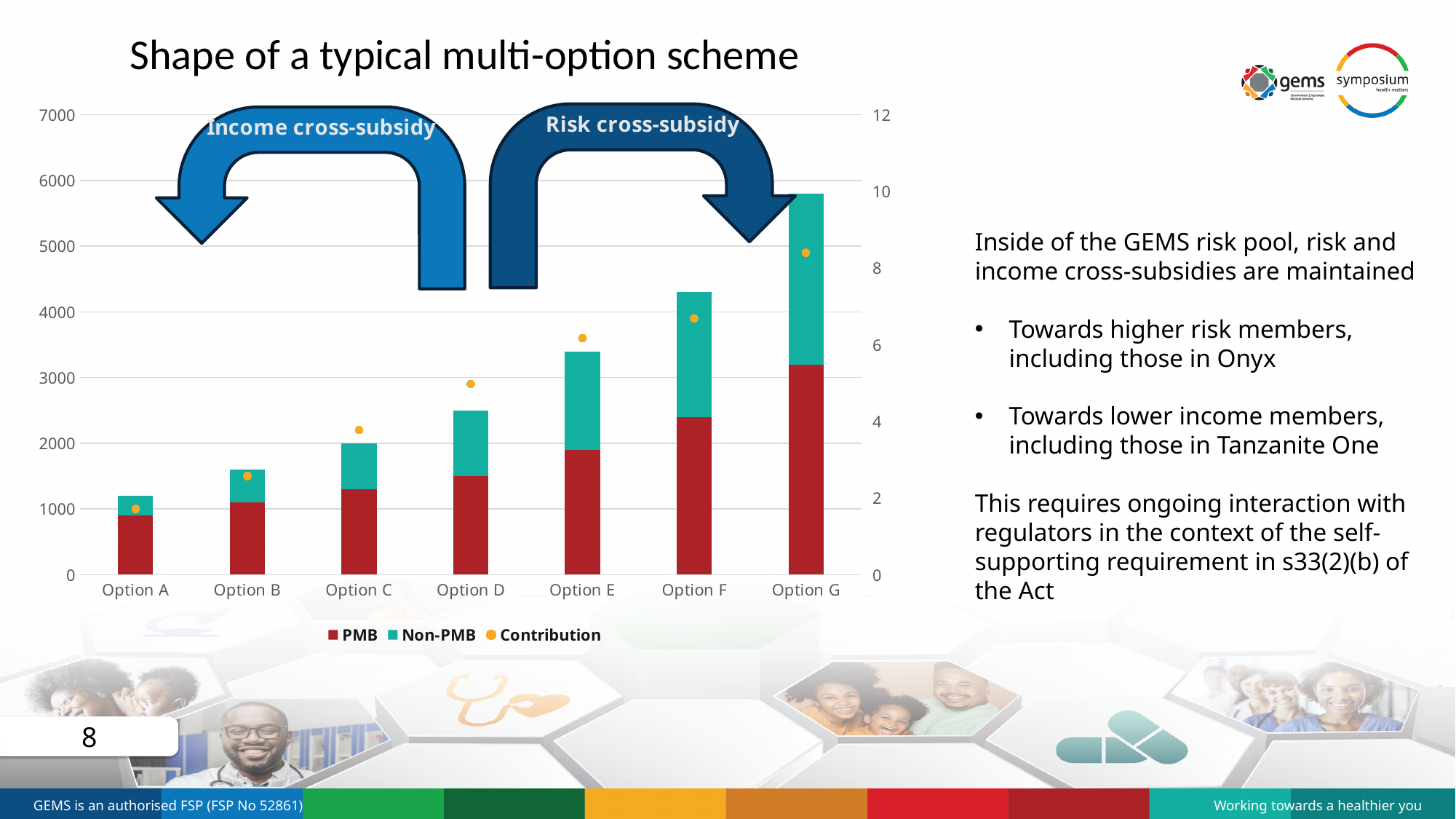
How many options (categories) are shown on the x axis of the chart? 7 Which option has the tallest stacked bar? Option G Do the stacked bar totals rise or fall from Option A to Option G? rise Is the PMB value for Option G greater or less than 3000? greater Which series in the legend is shown as orange dots? Contribution Which is larger, the stacked bar total for Option F or for Option E? Option F Is the total stacked bar for Option G greater or less than 5000? greater How many series does the chart legend list? 3 What are the two cross-subsidies labelled on the arrows above the chart? Income cross-subsidy and Risk cross-subsidy What kind of chart is shown on the slide? bar chart Is the total stacked bar for Option A greater or less than 2000? less Which option has the shortest stacked bar? Option A